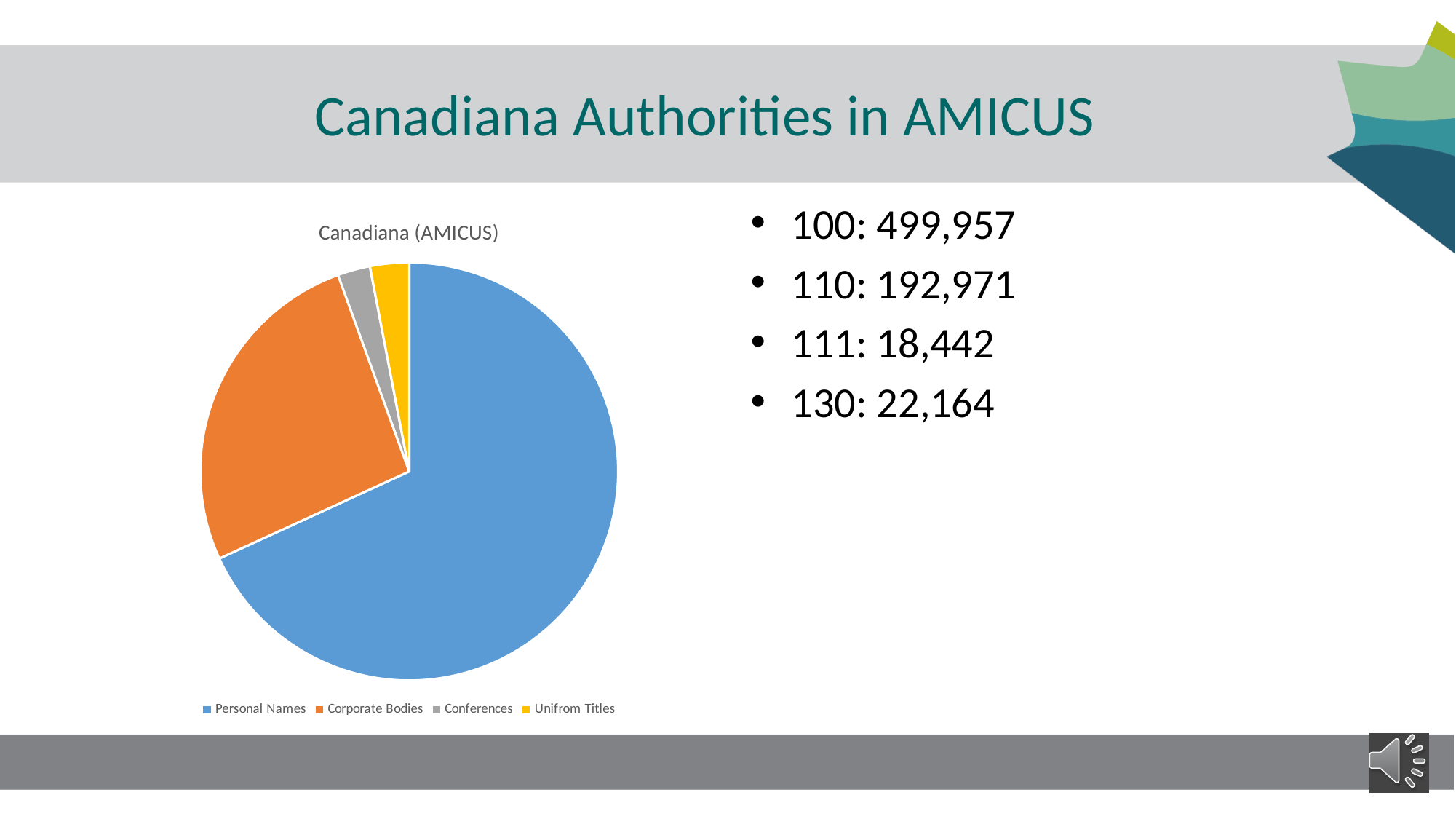
Which category has the second-largest slice in the pie chart? Corporate Bodies What colour is the Personal Names slice in the pie chart? blue Which category has the largest slice in the pie chart? Personal Names Is the Personal Names slice greater or less than half of the pie? greater What kind of chart is shown on the slide? pie chart Which slice is larger, Conferences or Personal Names? Personal Names Which slice is larger, Personal Names or Corporate Bodies? Personal Names Which slice is larger, Corporate Bodies or Uniform Titles? Corporate Bodies How many categories does the pie chart show? 4 What is the title of the pie chart? Canadiana (AMICUS)